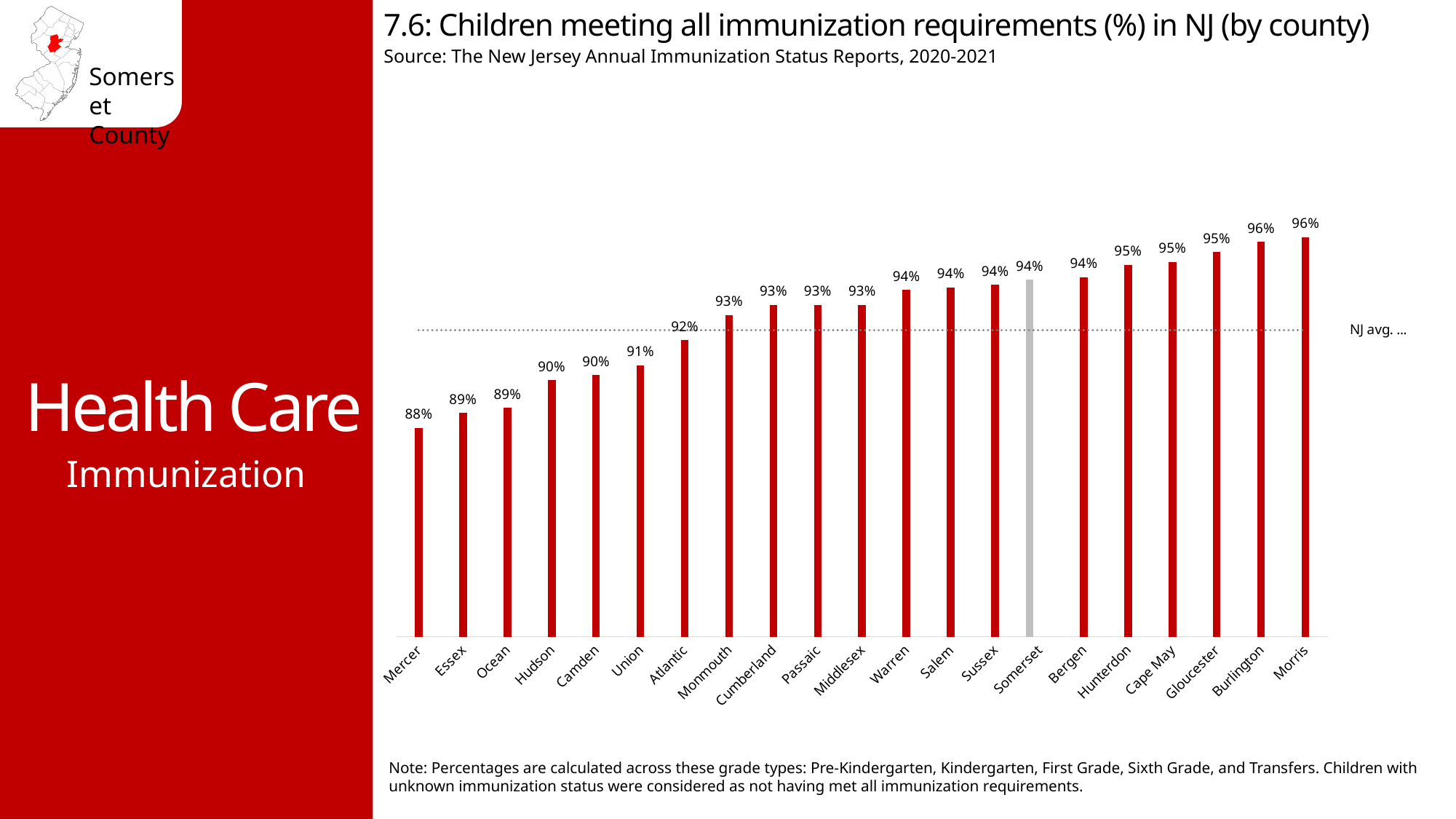
What percentage is shown for Atlantic County? 92% Which county has the lowest percentage of children meeting all immunization requirements? Mercer What is the difference in percentage points between Morris County and Mercer County? 8 percentage points What is the value shown for Mercer County? 88% Which has a higher value, Hudson County or Atlantic County? Atlantic Which county's bar is coloured grey instead of red? Somerset What is the difference in percentage points between Somerset County and Mercer County? 6 percentage points What percentage of children in Somerset County met all immunization requirements? 94% How many counties are shown on the chart? 21 What kind of chart is shown on the slide? Bar chart What is the value shown for Hunterdon County? 95% Do the values rise or fall moving from left to right along the x axis? Rise